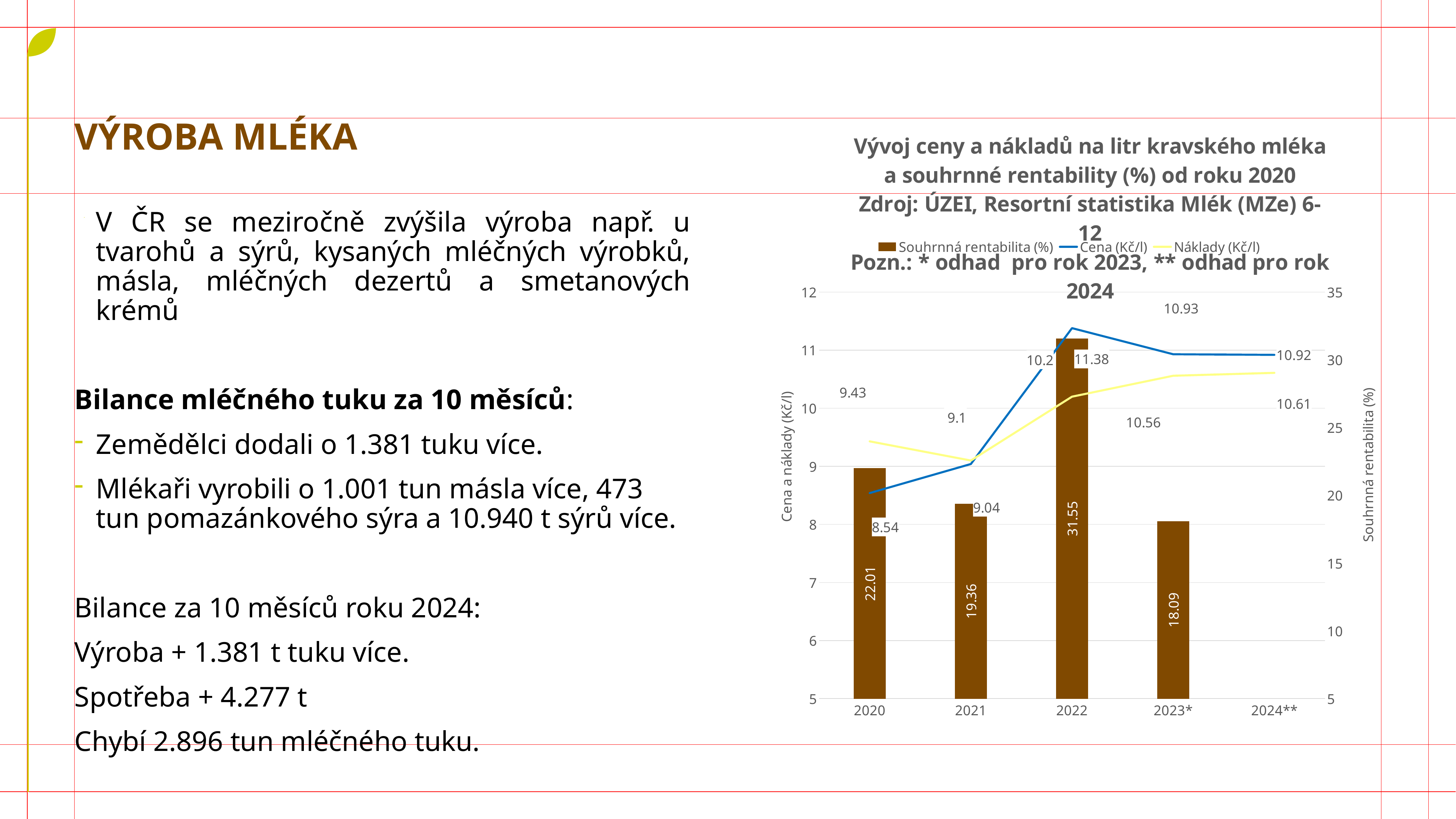
What is the Cena (Kč/l) value for 2022? 11.38 Which year has the lowest Souhrnná rentabilita (%) bar? 2023* What is the Náklady (Kč/l) value for 2020? 9.43 What is the Souhrnná rentabilita (%) value for 2022? 31.55 How many years are shown on the x axis of the chart? 5 What is the Cena (Kč/l) value for 2024**? 10.92 How many series does the chart legend list? 3 Does the Náklady (Kč/l) line rise or fall from 2021 to 2024**? Rise What is the difference between the Souhrnná rentabilita (%) values for 2020 and 2021? 2.65 What kind of chart is shown on the slide? A combination bar and line chart In 2020, which is larger: Cena (Kč/l) or Náklady (Kč/l)? Náklady (Kč/l) Which year has the highest Souhrnná rentabilita (%) bar? 2022